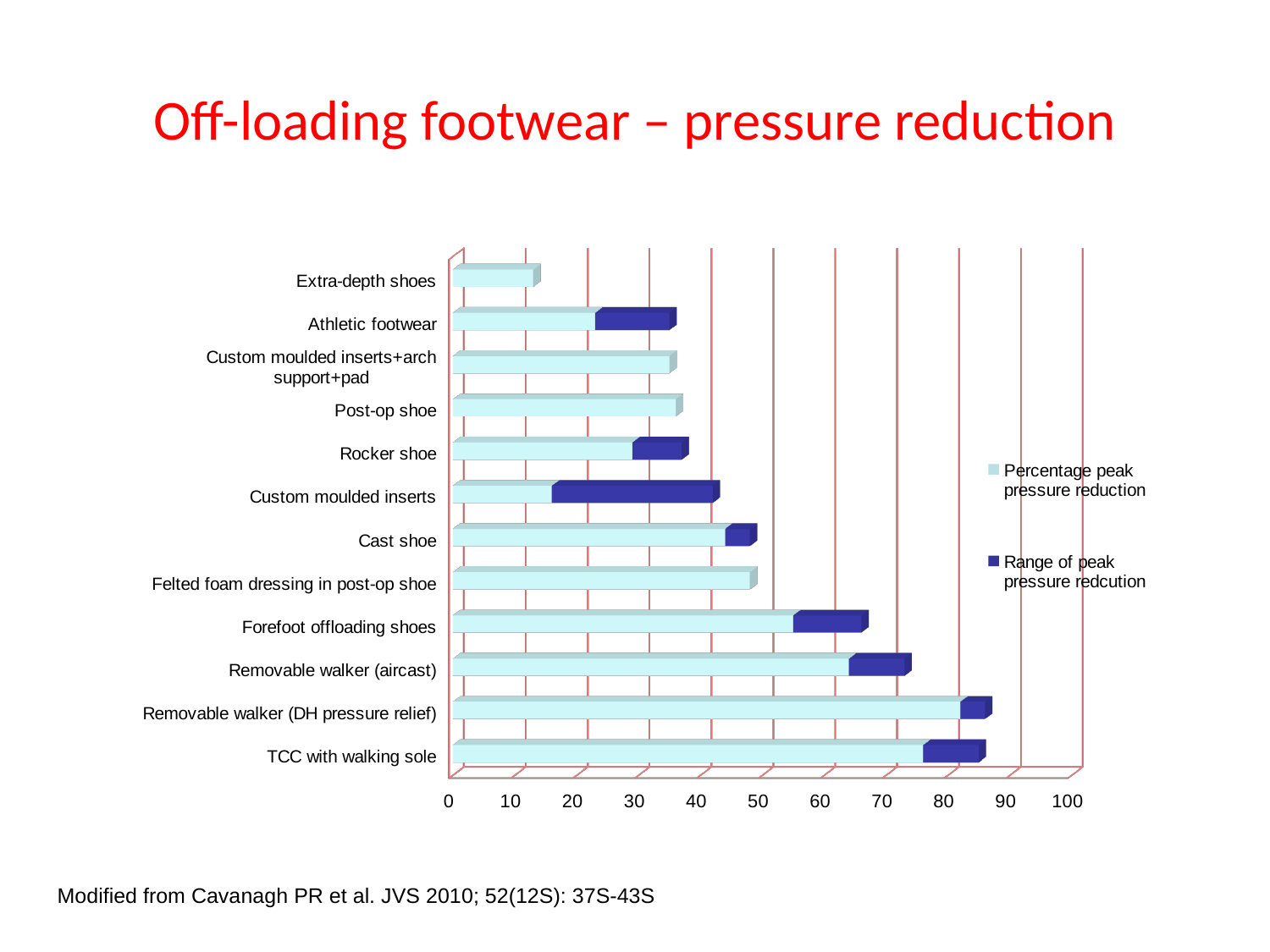
Which footwear category has the highest percentage peak pressure reduction (light blue bar)? Removable walker (DH pressure relief) How many series does the legend list? 2 Which footwear category has the lowest percentage peak pressure reduction? Extra-depth shoes Which has a larger percentage peak pressure reduction, Removable walker (aircast) or Rocker shoe? Removable walker (aircast) Which has a larger percentage peak pressure reduction, Custom moulded inserts or Cast shoe? Cast shoe Is the percentage peak pressure reduction for TCC with walking sole greater or less than 70? greater Is the percentage peak pressure reduction for Extra-depth shoes greater or less than 20? less Is the percentage peak pressure reduction for Athletic footwear greater or less than 30? less What kind of chart is shown on the slide? bar chart What are the two series named in the legend? Percentage peak pressure reduction; Range of peak pressure redcution How many footwear categories are plotted on the chart? 12